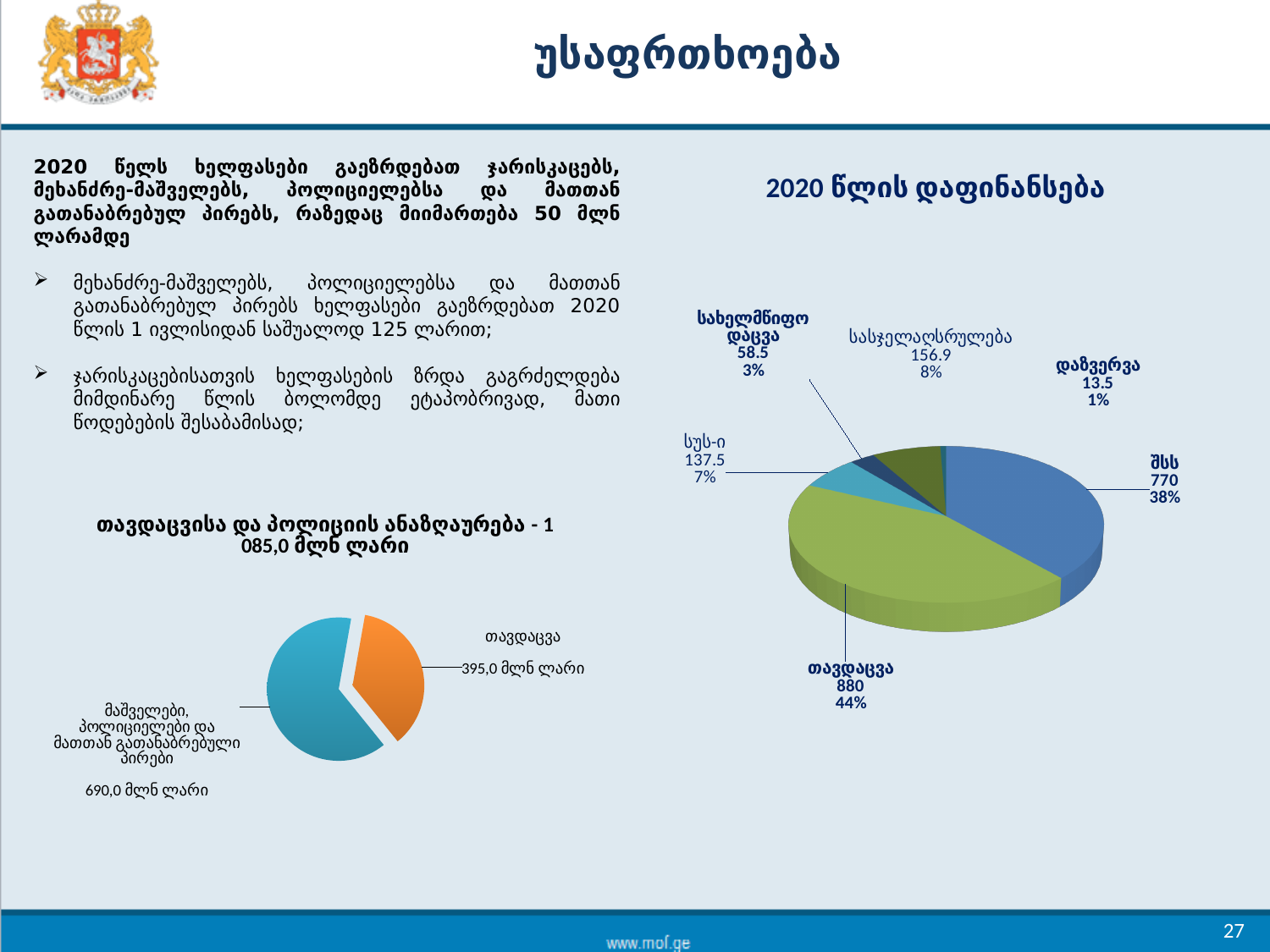
In the chart titled "თავდაცვისა და პოლიციის ანაზღაურება - 1 085,0 მლნ ლარი", what is the value for თავდაცვა? 395,0 მლნ ლარი In the "2020 წლის დაფინანსება" chart, which category has the smallest slice? დაზვერვა In the "2020 წლის დაფინანსება" chart, what is the value for სუს-ი? 137.5 In the "2020 წლის დაფინანსება" chart, which is larger: სახელმწიფო დაცვა or სუს-ი? სუს-ი In the "2020 წლის დაფინანსება" chart, what is the value for შსს? 770 In the "2020 წლის დაფინანსება" chart, which category has the largest slice? თავდაცვა In the "2020 წლის დაფინანსება" chart, what share of the pie does სასჯელაღსრულება have? 8% In the "2020 წლის დაფინანსება" chart, what is the difference between the values for თავდაცვა and შსს? 110 In the "2020 წლის დაფინანსება" chart, what is the value for თავდაცვა? 880 In the chart titled "თავდაცვისა და პოლიციის ანაზღაურება - 1 085,0 მლნ ლარი", what is the value for მაშველები, პოლიციელები და მათთან გათანაბრებული პირები? 690,0 მლნ ლარი In the "2020 წლის დაფინანსება" chart, how many categories are shown? 6 What type of chart is the chart on the right side of the slide? Pie chart